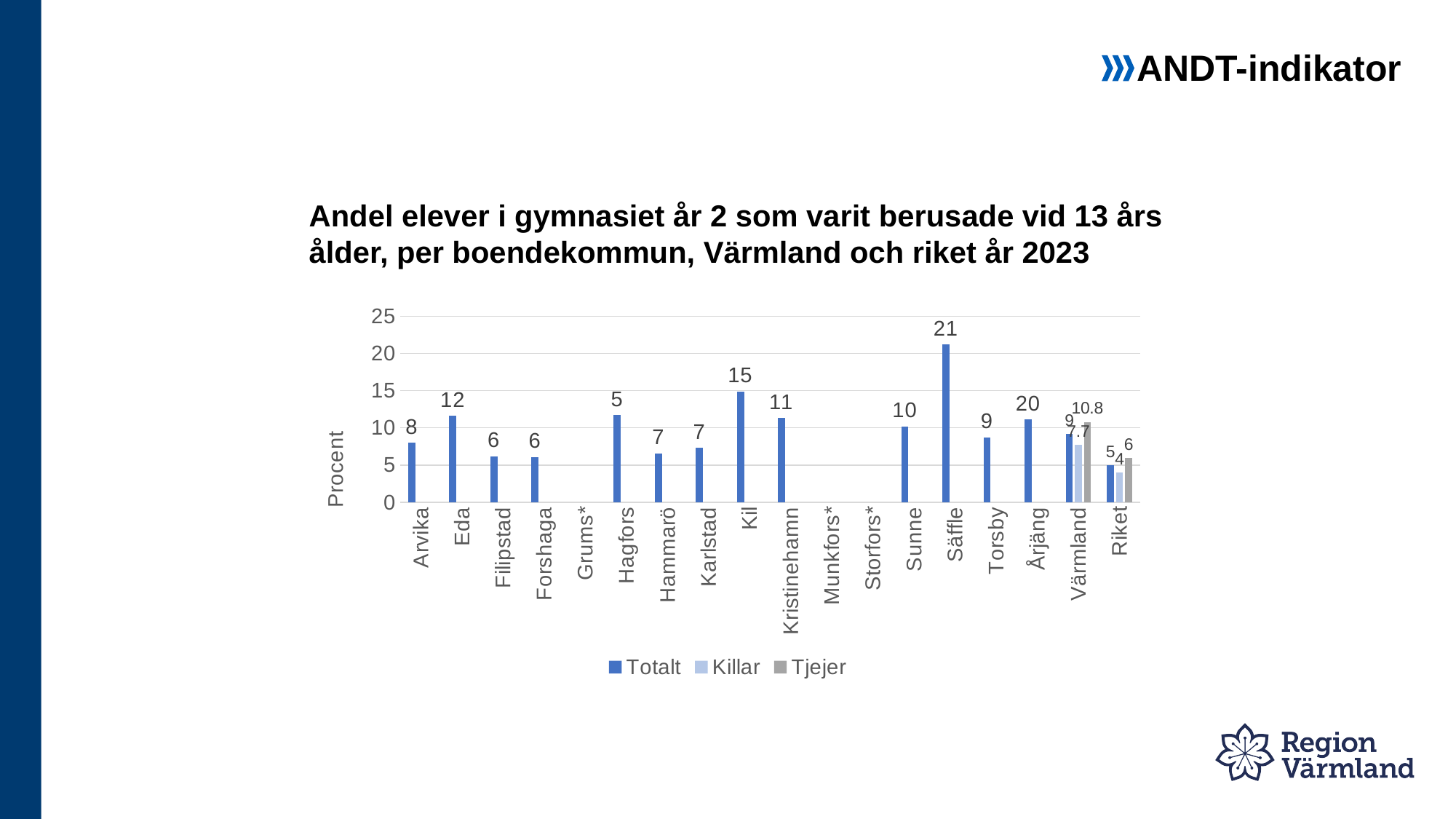
What is the difference between the Totalt values for Kil and Kristinehamn? 4 How many series does the legend list? 3 How many categories are shown on the x axis? 18 What kind of chart is shown on the slide? bar chart What is the Killar value for Riket? 4 What is the Totalt value for Kil? 15 Which category has the highest Totalt value? Säffle What is the Tjejer value for Värmland? 10.8 What is the Totalt value for Säffle? 21 Which has a higher Totalt value, Eda or Arvika? Eda What is the label on the y axis? Procent What is the difference between the Tjejer and Killar values for Värmland? 3.1